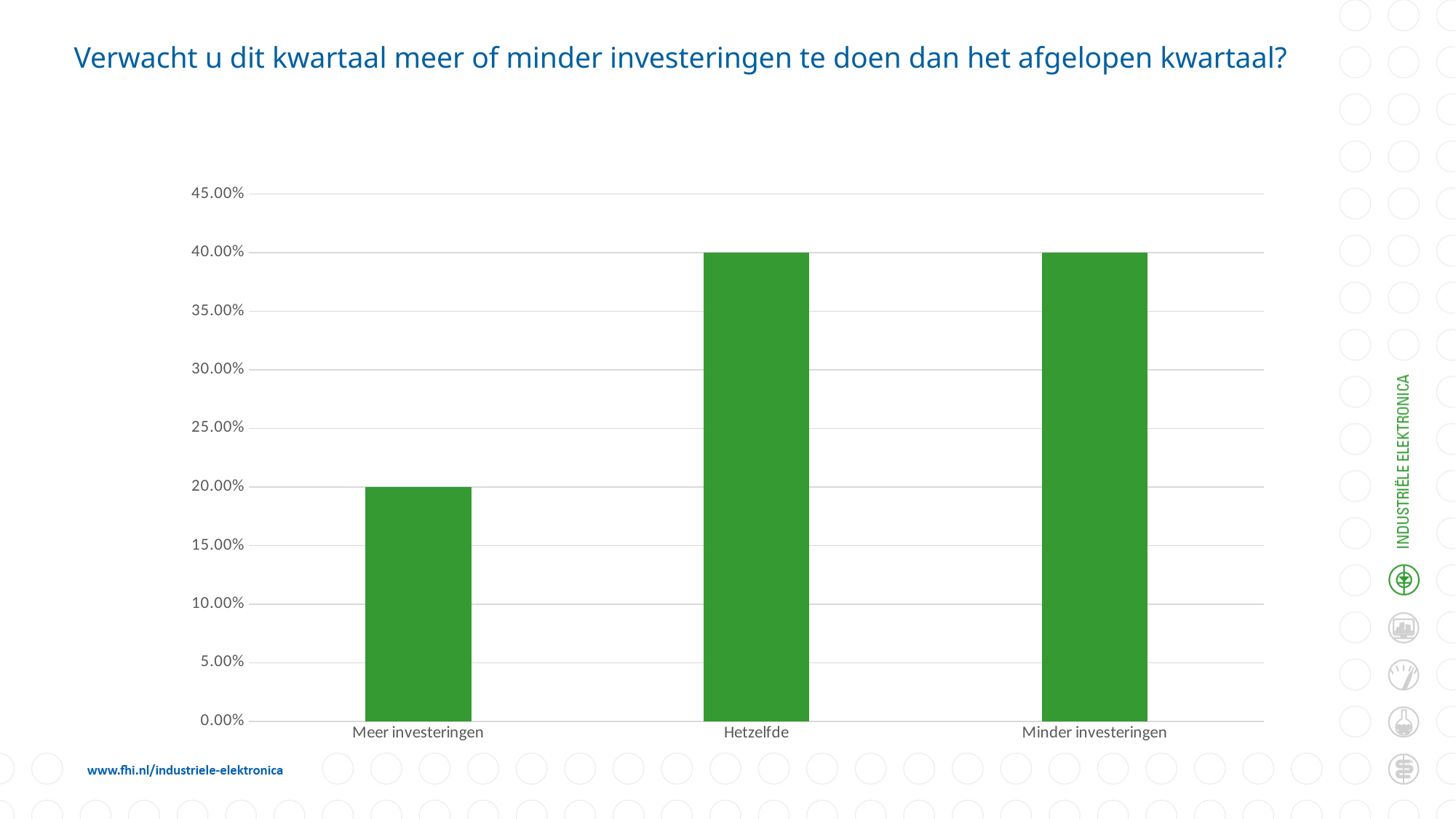
Which category has the lowest value? Meer investeringen What is the value for 'Minder investeringen'? 40.00% What is the value for 'Meer investeringen'? 20.00% Which is larger, the value for 'Hetzelfde' or the value for 'Meer investeringen'? Hetzelfde What is the title of the slide above the chart? Verwacht u dit kwartaal meer of minder investeringen te doen dan het afgelopen kwartaal? Is the value for 'Hetzelfde' greater or less than 35.00%? greater What is the value for 'Hetzelfde'? 40.00% What colour are the bars in the chart? green How many categories are shown on the x axis of the chart? 3 What is the difference between the value for 'Minder investeringen' and the value for 'Meer investeringen'? 20.00% Is the value for 'Meer investeringen' greater or less than 25.00%? less What kind of chart is shown on the slide? bar chart